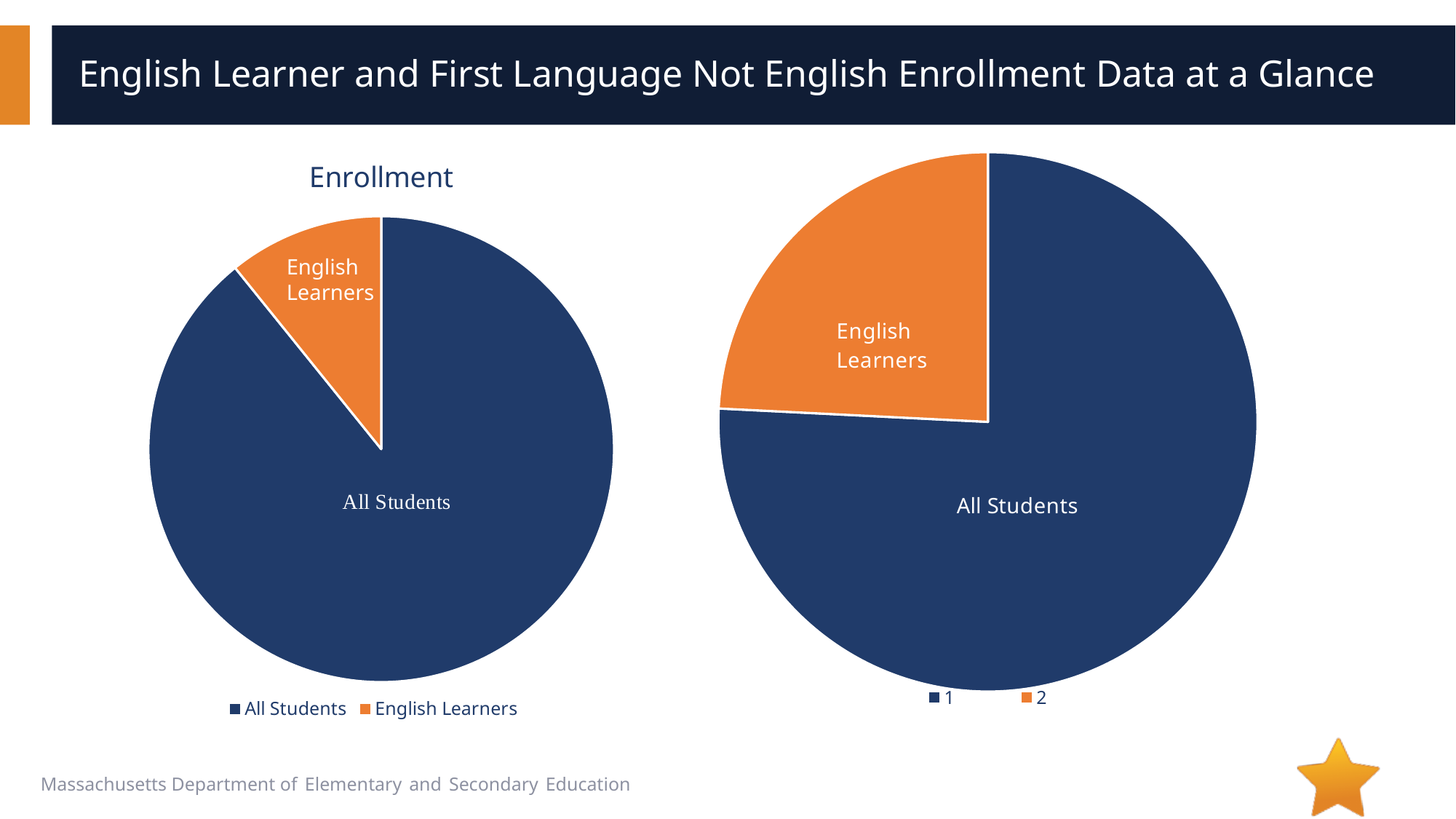
In the right chart, which slice is the smallest? English Learners In the right chart, how many slices does the pie have? 2 In the right chart, which slice is the largest? All Students In the left chart titled "Enrollment", how many slices does the pie have? 2 In the left chart titled "Enrollment", which slice is the largest? All Students What kind of chart is the left chart titled "Enrollment"? pie chart What is the title of the left chart? Enrollment What kind of chart is the right chart on the slide? pie chart How many entries does the legend of the left chart titled "Enrollment" list? 2 What are the two legend entries shown below the right chart? 1 and 2 In the left chart titled "Enrollment", which slice is the smallest? English Learners In the left chart titled "Enrollment", which slice is larger, All Students or English Learners? All Students